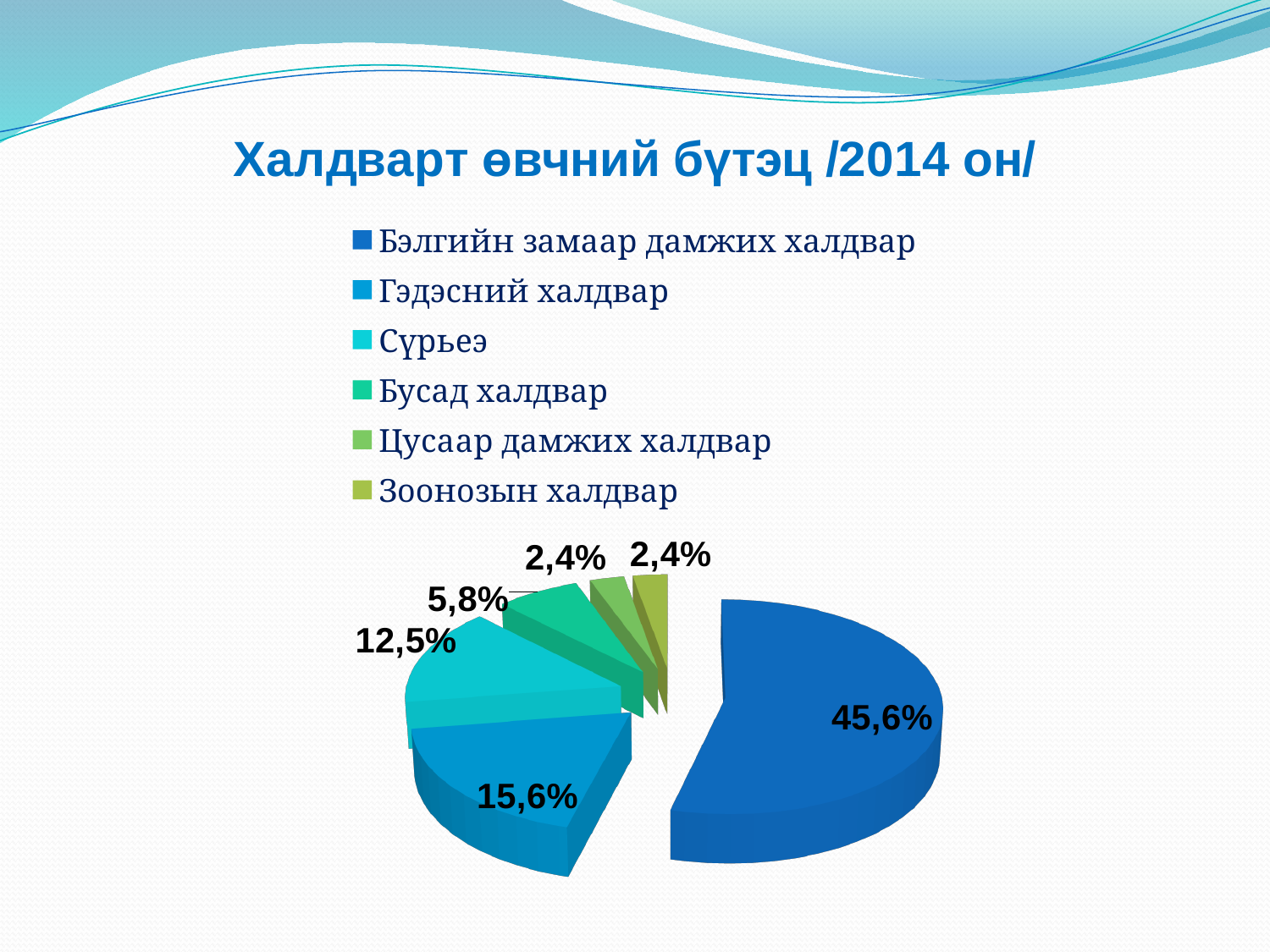
What is the difference between the values for Бэлгийн замаар дамжих халдвар and Гэдэсний халдвар? 30 percentage points Which is larger, the value for Сүрьеэ or the value for Бусад халдвар? Сүрьеэ What is the value shown for Гэдэсний халдвар? 15,6% What is the value shown for Сүрьеэ? 12,5% What is the value shown for Зоонозын халдвар? 2,4% What kind of chart is shown on the slide? pie chart What is the value shown for Бусад халдвар? 5,8% Which category has the largest slice of the pie? Бэлгийн замаар дамжих халдвар What share of the pie is Бэлгийн замаар дамжих халдвар? 45,6% What is the title of the chart? Халдварт өвчний бүтэц /2014 он/ How many categories does the legend list? 6 How many slices does the pie chart have? 6